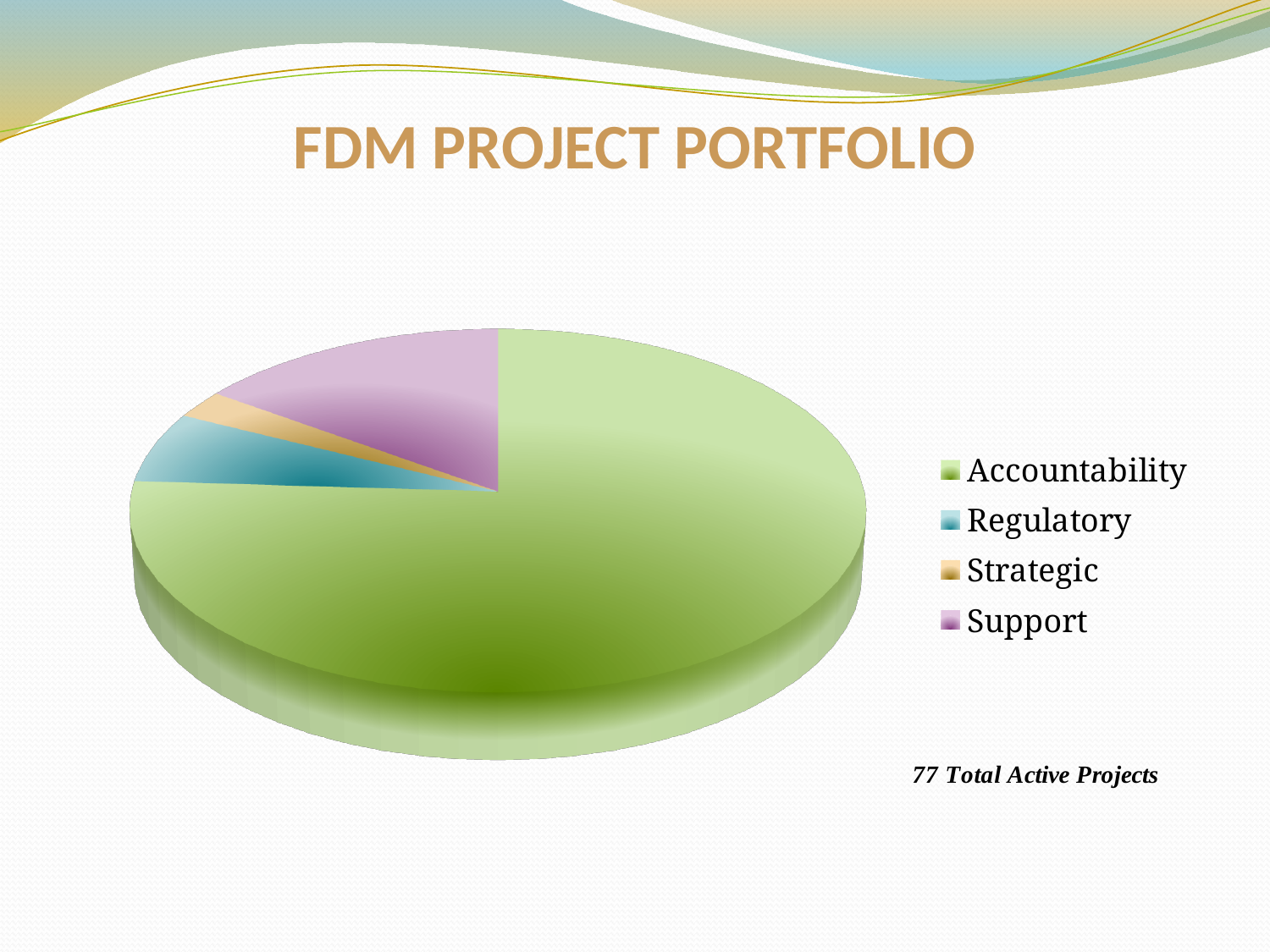
Which slice is larger, Regulatory or Strategic? Regulatory How many categories does the pie chart show? 4 What kind of chart is shown on the slide? Pie chart Which slice is larger, Accountability or Support? Accountability Which category has the largest slice of the pie? Accountability What is the title of the slide containing the pie chart? FDM PROJECT PORTFOLIO Which category has the smallest slice of the pie? Strategic How many entries does the legend list? 4 Which slice is larger, Support or Regulatory? Support According to the text below the legend, how many total active projects are there? 77